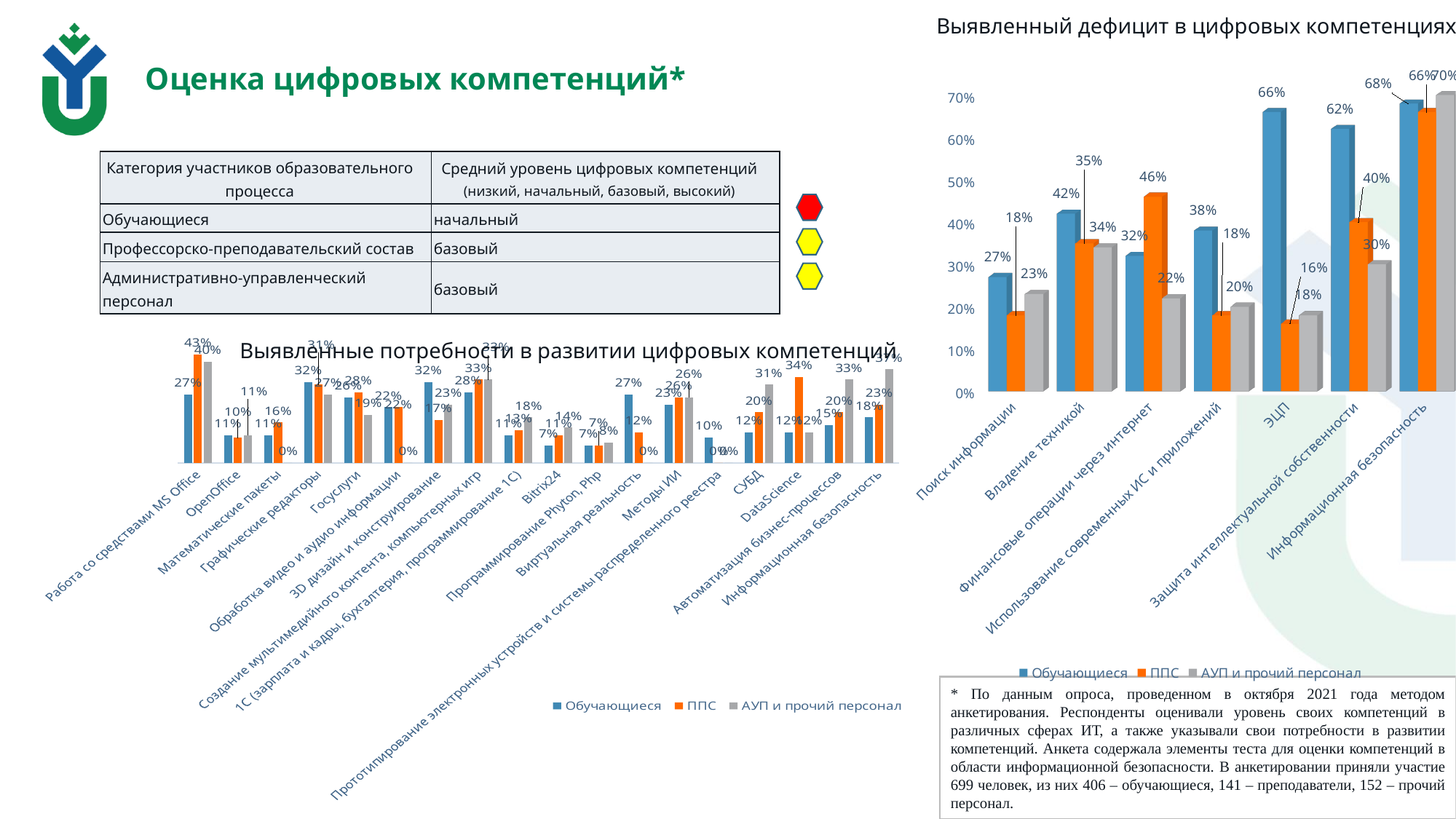
In the chart 'Выявленные потребности в развитии цифровых компетенций', what is the value for ППС in the category Работа со средствами MS Office? 43% In the chart 'Выявленный дефицит в цифровых компетенциях', which category has the lowest value for ППС? ЭЦП How many series does the legend of the chart 'Выявленный дефицит в цифровых компетенциях' list? 3 In the chart 'Выявленный дефицит в цифровых компетенциях', which is larger in the category Владение техникой: Обучающиеся or ППС? Обучающиеся How many categories are shown on the x axis of the chart 'Выявленный дефицит в цифровых компетенциях'? 7 In the chart 'Выявленный дефицит в цифровых компетенциях', what is the value for ППС in the category Финансовые операции через интернет? 46% In the chart 'Выявленный дефицит в цифровых компетенциях', what is the value for Обучающиеся in the category ЭЦП? 66% In the chart 'Выявленный дефицит в цифровых компетенциях', what is the value for АУП и прочий персонал in the category Информационная безопасность? 70% In the chart 'Выявленный дефицит в цифровых компетенциях', what is the difference between Обучающиеся and ППС in the category Защита интеллектуальной собственности? 22% In the chart 'Выявленные потребности в развитии цифровых компетенций', what is the value for АУП и прочий персонал in the category Информационная безопасность? 37% In the chart 'Выявленный дефицит в цифровых компетенциях', which category has the highest value for Обучающиеся? Информационная безопасность What kind of chart is 'Выявленные потребности в развитии цифровых компетенций'? Bar chart